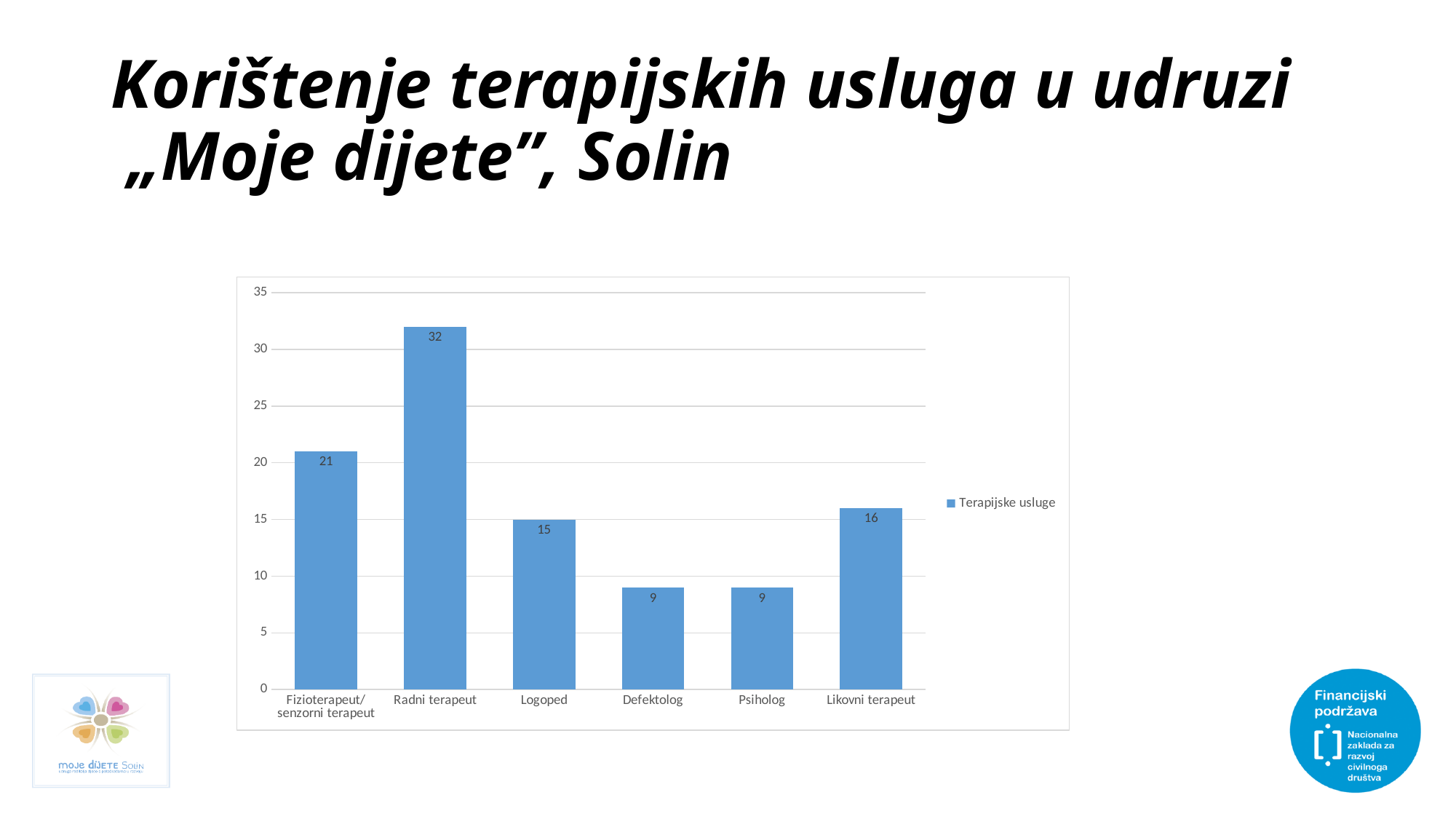
How many series does the legend list? 1 What is the value for Logoped? 15 How many categories are shown on the x axis? 6 What is the value for Fizioterapeut/senzorni terapeut? 21 What kind of chart is shown on the slide? bar chart Is the value for Psiholog greater or less than 10? less Which is larger, the value for Logoped or the value for Likovni terapeut? Likovni terapeut What is the difference between the values for Radni terapeut and Likovni terapeut? 16 What is the difference between the values for Fizioterapeut/senzorni terapeut and Defektolog? 12 Which category has the highest value? Radni terapeut What is the value for Radni terapeut? 32 What is the name of the series in the legend? Terapijske usluge